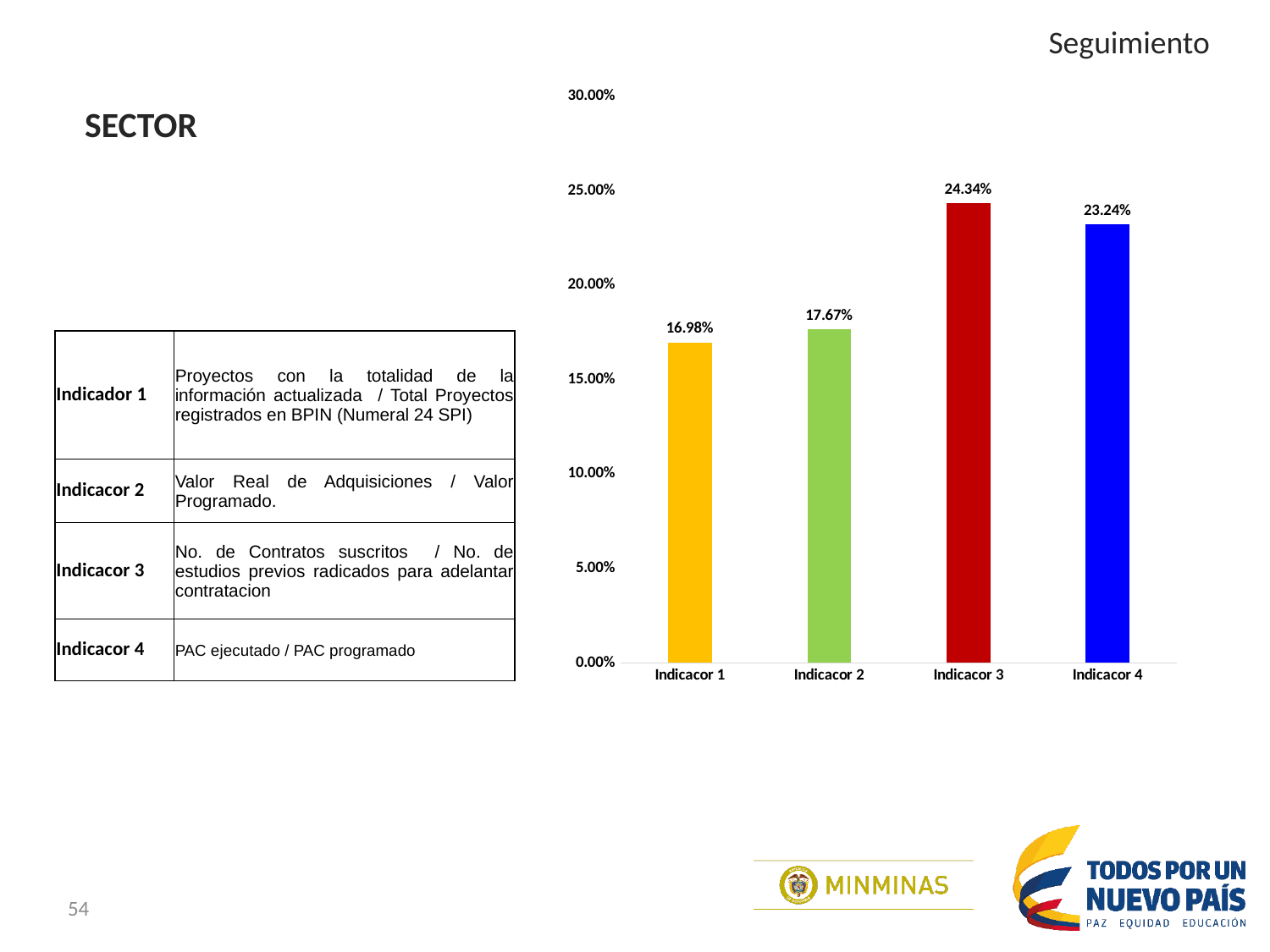
Is the value for Indicacor 4 greater or less than 20.00%? greater What is the value for Indicacor 1? 16.98% Which is larger, the value for Indicacor 3 or the value for Indicacor 4? Indicacor 3 Which category has the lowest value? Indicacor 1 What kind of chart is shown on the slide? bar chart What is the difference between the values for Indicacor 3 and Indicacor 4? 1.10% What is the value for Indicacor 4? 23.24% Which category has the highest value? Indicacor 3 How many categories are shown on the chart? 4 What is the difference between the values for Indicacor 2 and Indicacor 1? 0.69% What is the value for Indicacor 3? 24.34% What is the value for Indicacor 2? 17.67%